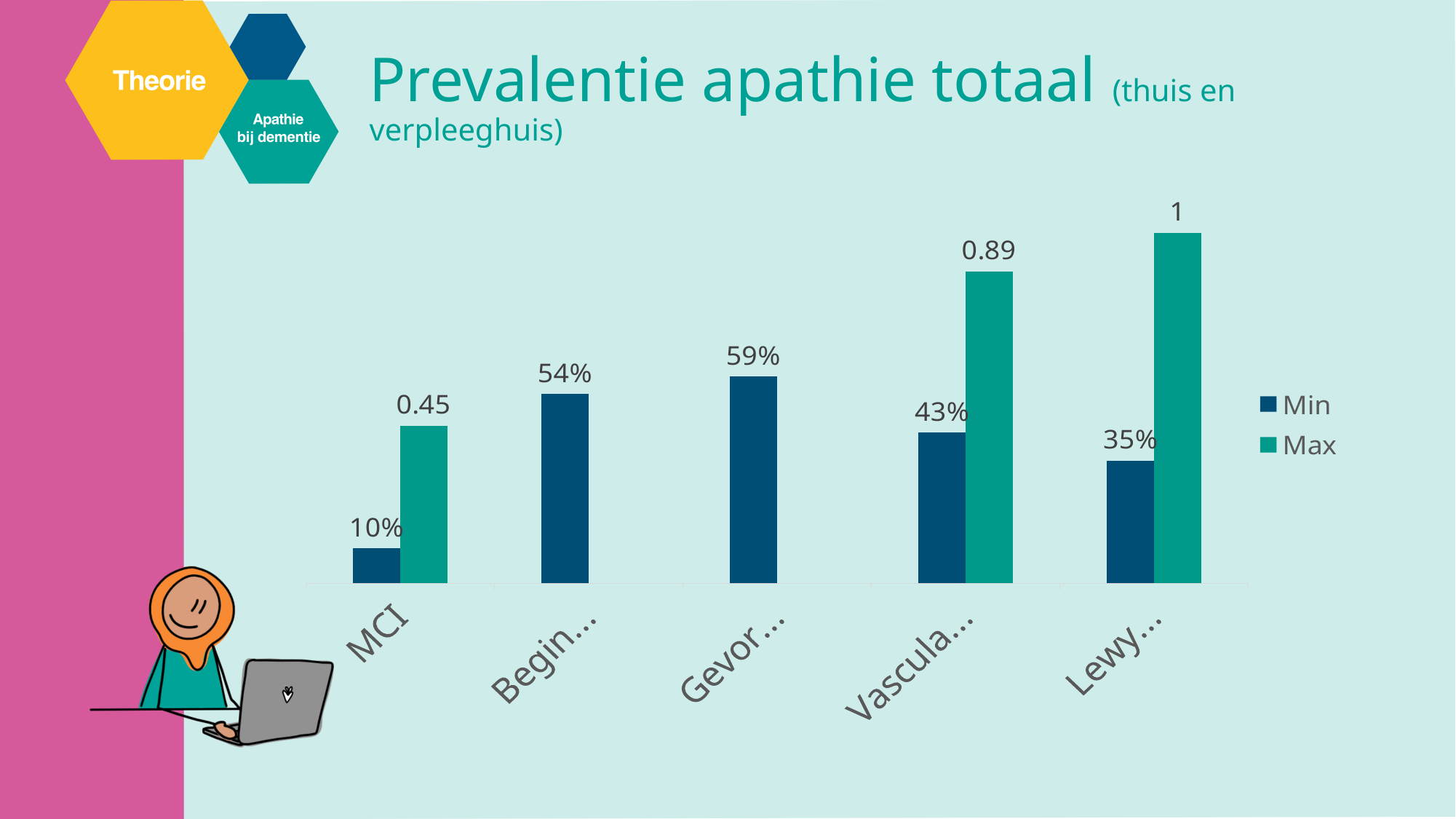
Which category has the highest Min value? Gevor… How many categories are shown on the x axis? 5 What is the Max value for the category labelled "Lewy…"? 1 Which category has the lowest Min value? MCI What is the Min value for the category labelled "Lewy…"? 35% How many series does the legend list? 2 What is the Min value for MCI? 10% Which has the larger Min value, "Begin…" or "Gevor…"? Gevor… What kind of chart is shown on the slide? Bar chart What is the difference between the Min values for "Vascula…" and "Lewy…"? 8% What is the Max value for MCI? 0.45 What is the Max value for the category labelled "Vascula…"? 0.89